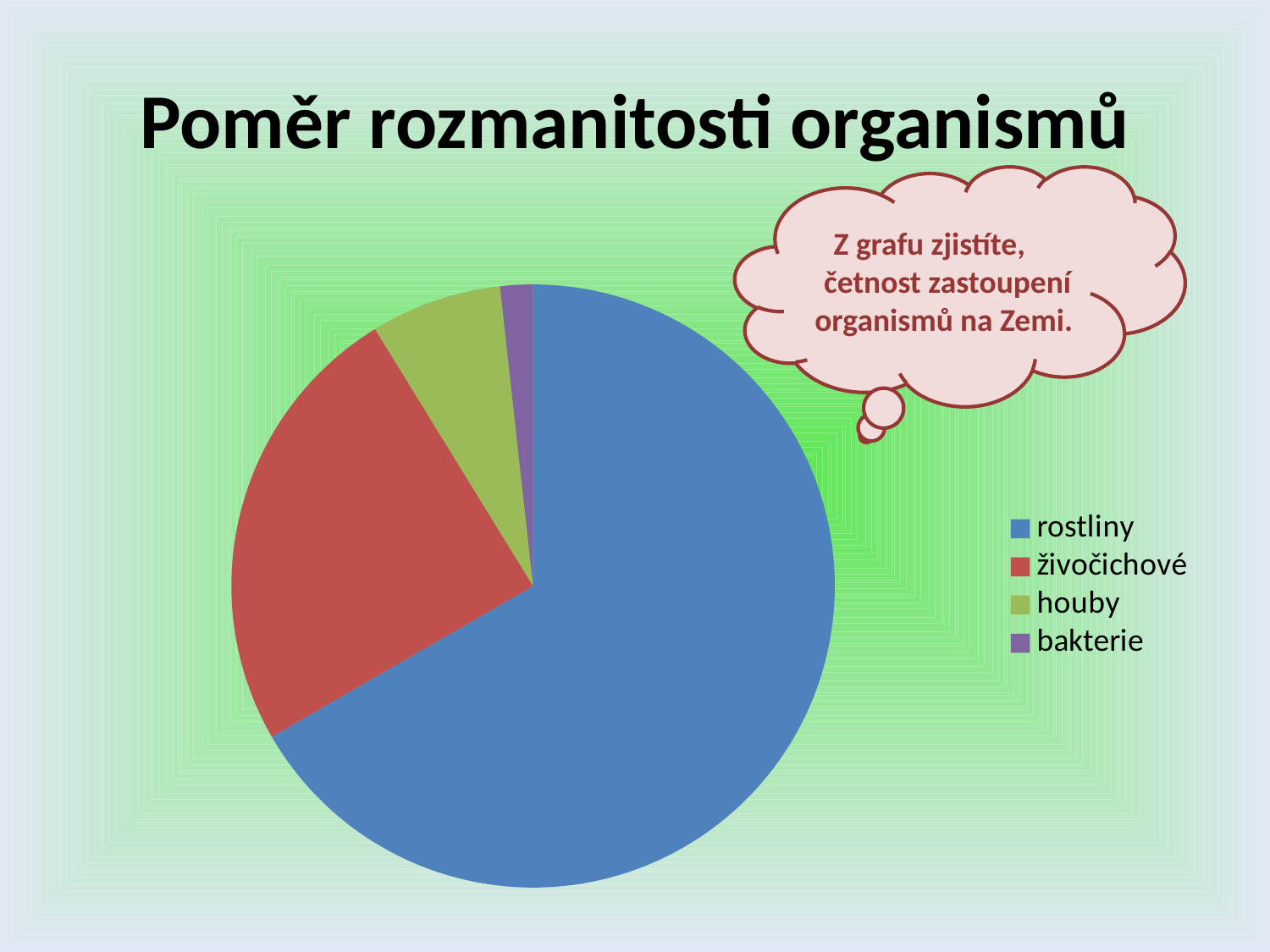
Which slice is larger, rostliny or živočichové? rostliny Which slice is larger, houby or bakterie? houby Which category has the largest slice of the pie? rostliny Which slice is larger, živočichové or houby? živočichové Which category has the second largest slice of the pie? živočichové How many categories does the pie chart show? 4 What kind of chart is shown on the slide? pie chart How many entries does the legend list? 4 What is the title of the chart on the slide? Poměr rozmanitosti organismů Which category is shown in blue in the pie chart? rostliny Which category has the smallest slice of the pie? bakterie